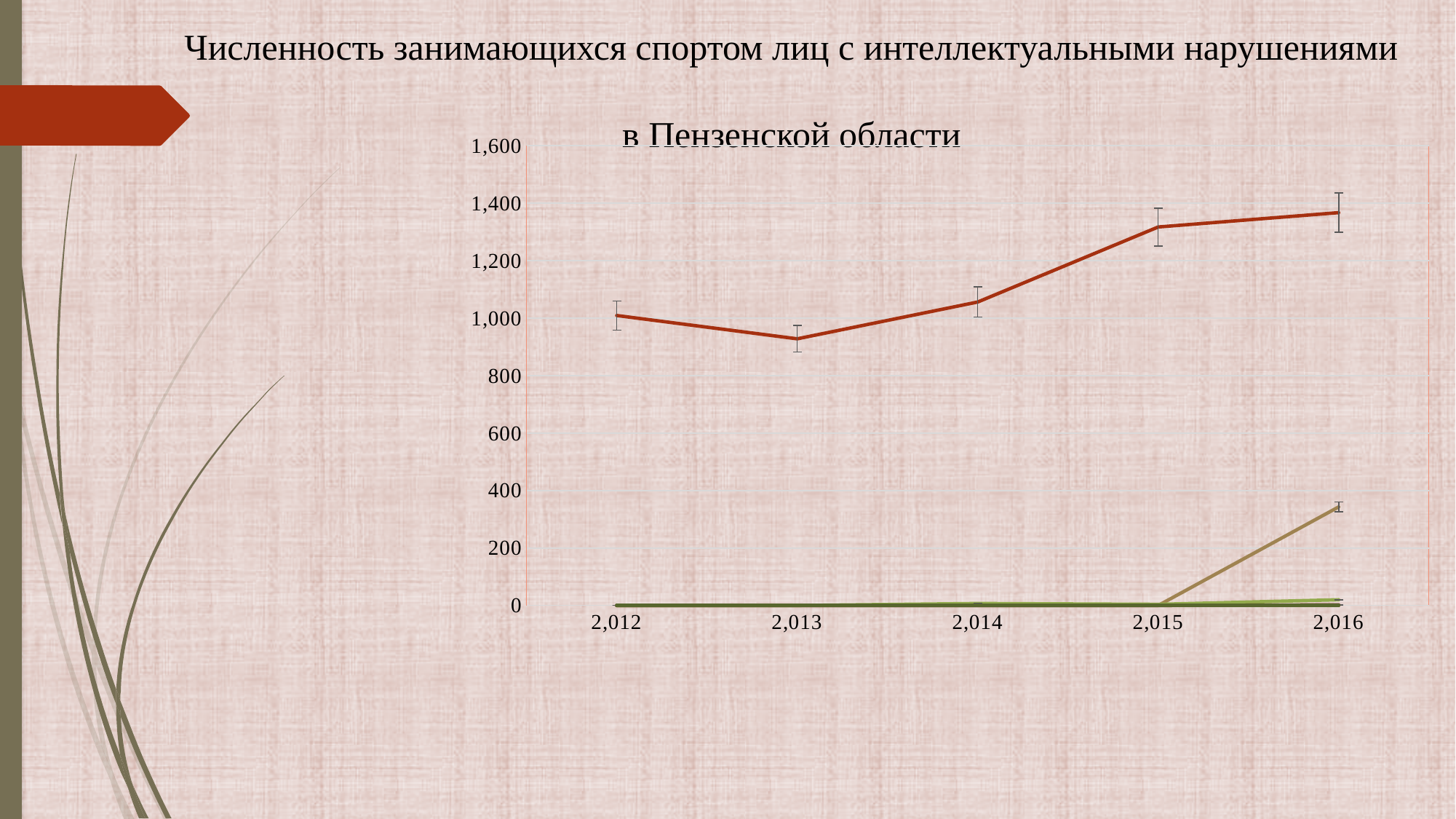
Is the value of the red line for 2,013 greater or less than 1,000? less Is the value of the olive line for 2,016 greater or less than 400? less Is the value of the red line for 2,016 greater or less than 1,400? less What is the first year shown on the x axis of the chart? 2,012 Does the red line rise or fall between 2,013 and 2,016? rise What kind of chart is shown on the slide? line chart How many years are shown along the x axis of the chart? 5 What is the last year shown on the x axis of the chart? 2,016 In which year does the red line reach its lowest value? 2,013 In which year does the red line reach its highest value? 2,016